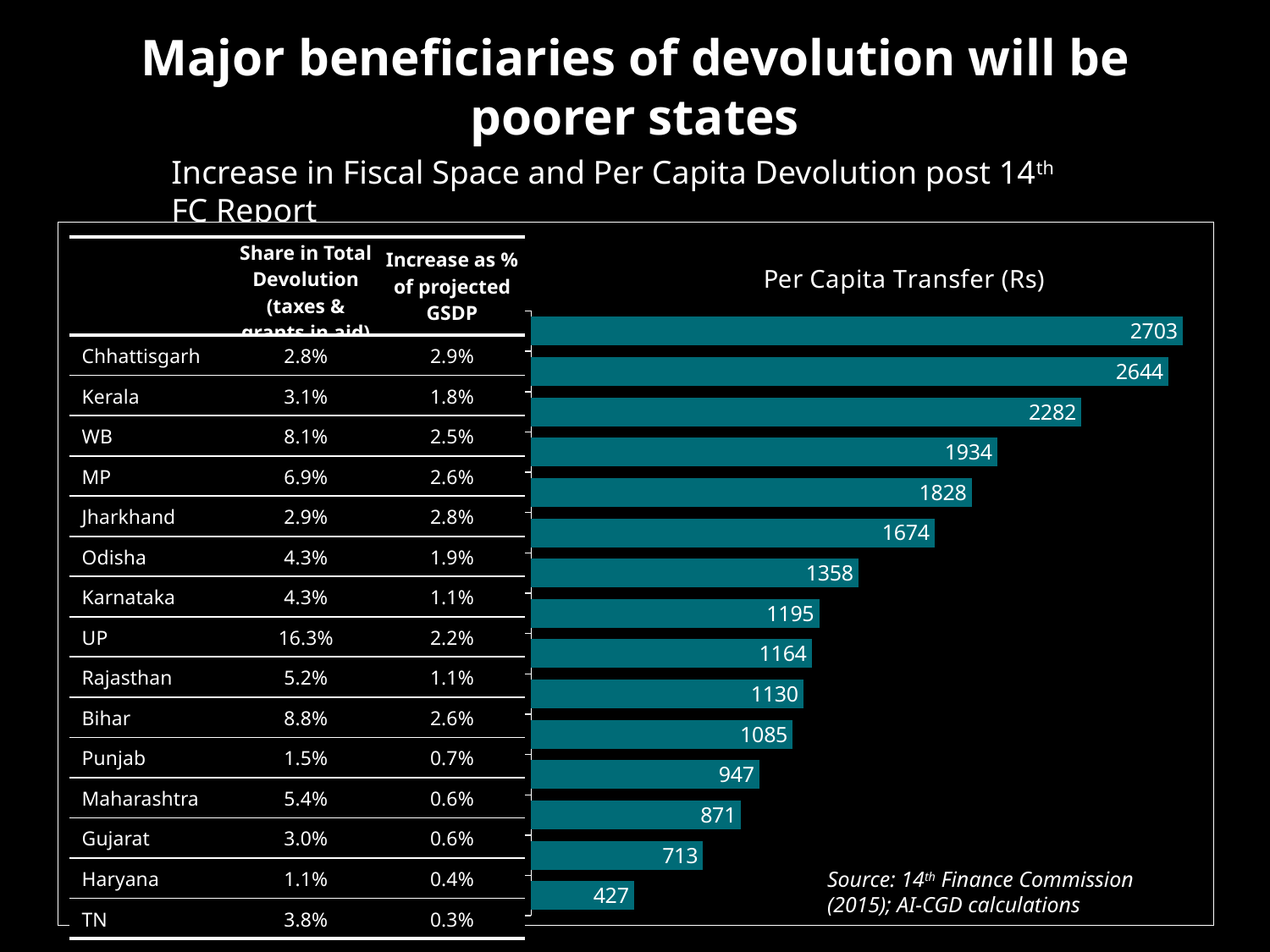
In the Per Capita Transfer (Rs) chart, do the bar values increase or decrease going from the top bar to the bottom bar? decrease What is the lowest value shown in the Per Capita Transfer (Rs) chart? 427 In the Per Capita Transfer (Rs) chart, which is larger: the top bar or the second bar from the top? the top bar (2703) In the Per Capita Transfer (Rs) chart, what is the value of the third bar from the top? 2282 In the Per Capita Transfer (Rs) chart, what is the difference between the top two bars (2703 and 2644)? 59 What kind of chart is shown on the right side of the slide? bar chart What is the title of the chart on the slide? Per Capita Transfer (Rs) In the Per Capita Transfer (Rs) chart, what is the value of the bottom bar? 427 In the Per Capita Transfer (Rs) chart, what is the difference between the highest value and the lowest value? 2276 How many bars does the Per Capita Transfer (Rs) chart contain? 15 What is the highest value shown in the Per Capita Transfer (Rs) chart? 2703 In the Per Capita Transfer (Rs) chart, what is the value of the fourth bar from the top? 1934